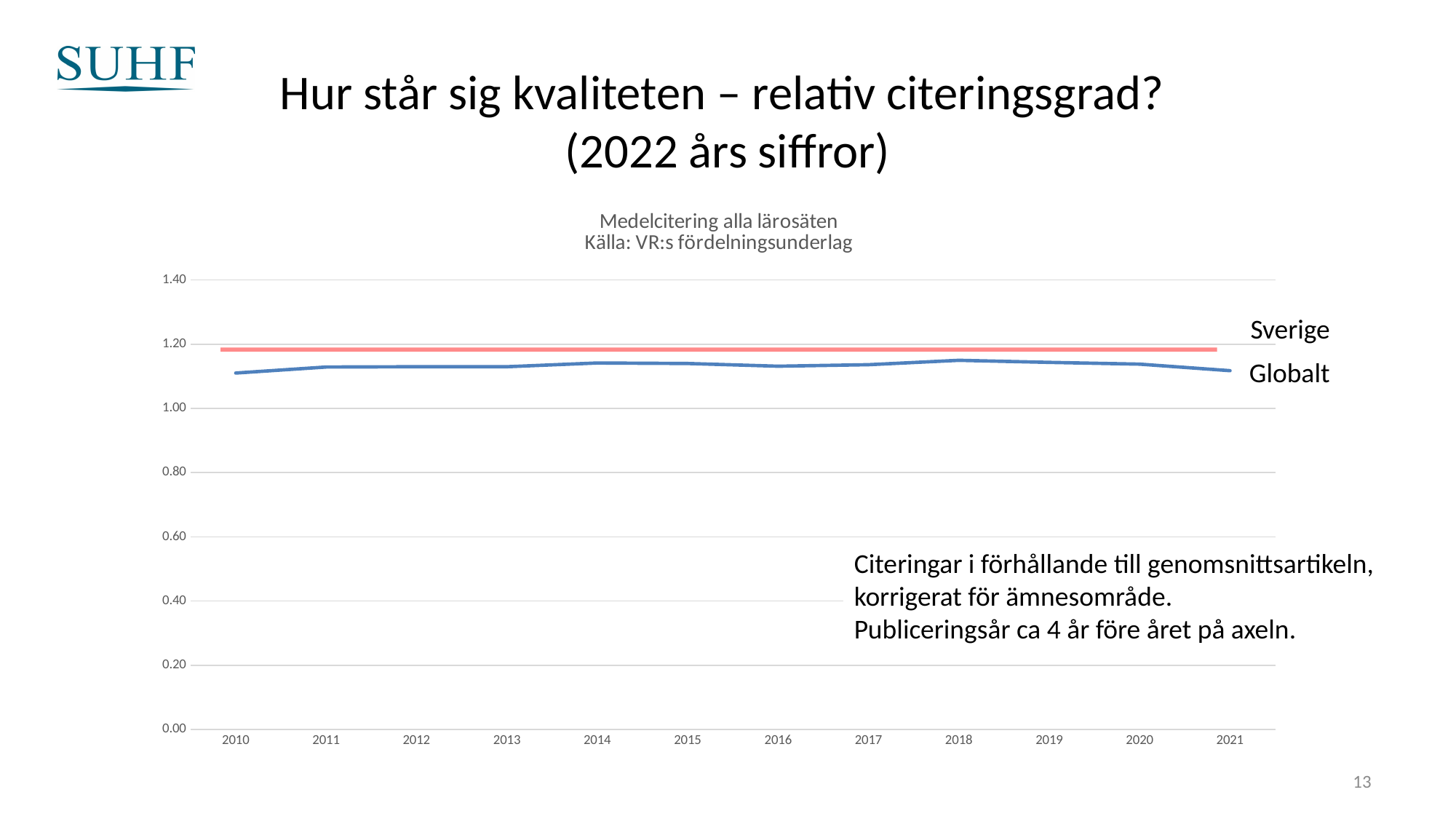
Is the value for Globalt in 2018 greater or less than 1.20? less How many years are shown on the x axis of the chart? 12 What kind of chart is shown on the slide? Line chart How many series does the chart show? 2 Which series has the higher value in 2021, Sverige or Globalt? Sverige What is the title of the chart? Medelcitering alla lärosäten Källa: VR:s fördelningsunderlag Does the Globalt line rise or fall from 2018 to 2021? fall What is the last year shown on the x axis? 2021 Is the value for Sverige in 2015 greater or less than 1.00? greater Which series has the higher value in 2010, Sverige or Globalt? Sverige What is the first year shown on the x axis? 2010 Is the value for Globalt in 2010 greater or less than 1.00? greater